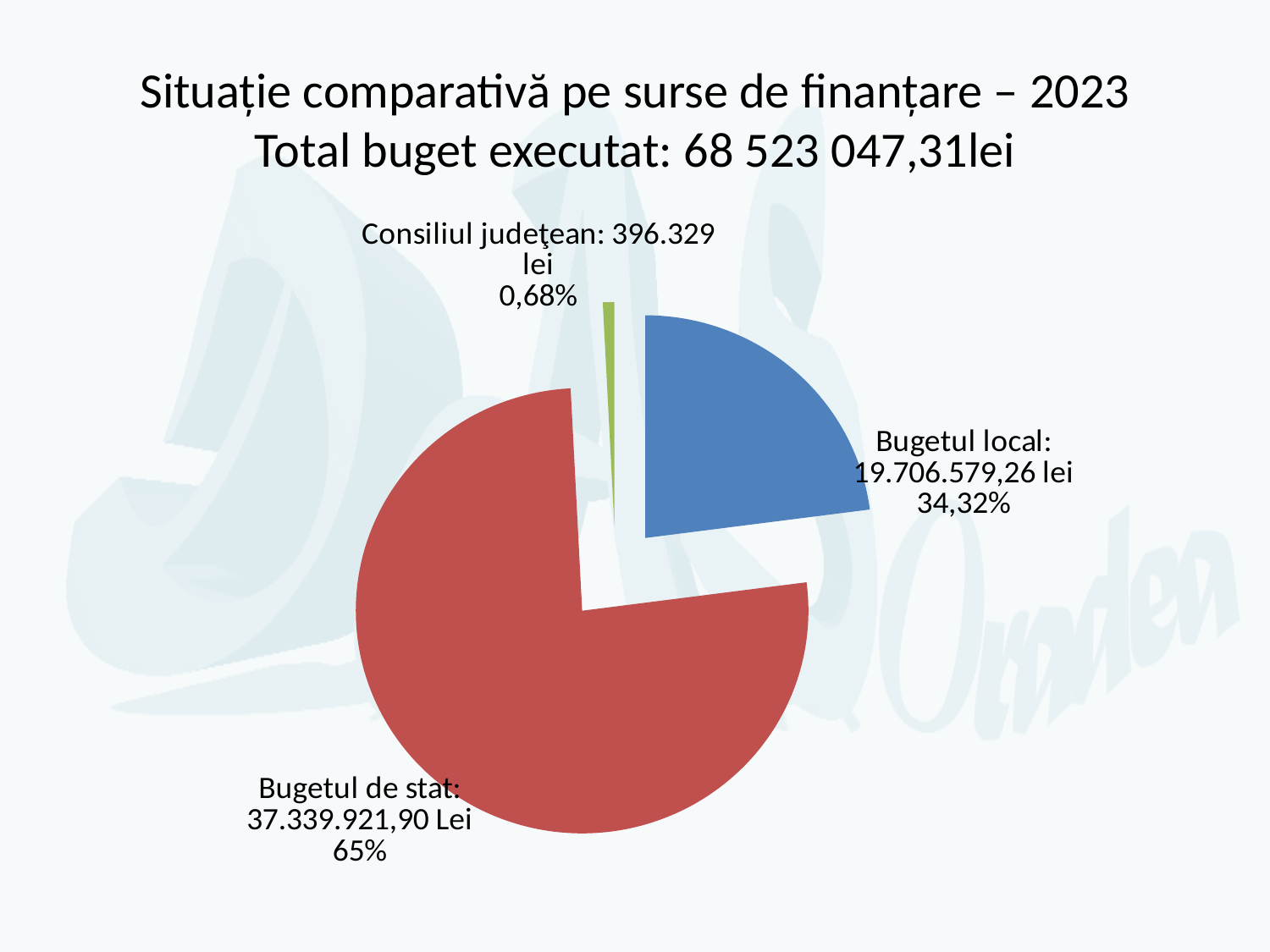
What total budget is stated in the chart title? 68 523 047,31lei What kind of chart is shown on the slide? pie chart Which source of funding has the smallest slice of the pie? Consiliul județean What is the value shown for Bugetul de stat? 37.339.921,90 Lei What is the difference in percentage points between the share of Bugetul de stat and the share of Bugetul local? 30,68% How many slices does the pie chart have? 3 Which source of funding has the largest slice of the pie? Bugetul de stat What share of the pie does Consiliul județean represent? 0,68% Which is larger, Bugetul local or Consiliul județean? Bugetul local What share of the pie does Bugetul local represent? 34,32% What is the value shown for Bugetul local? 19.706.579,26 lei What is the value shown for Consiliul județean? 396.329 lei